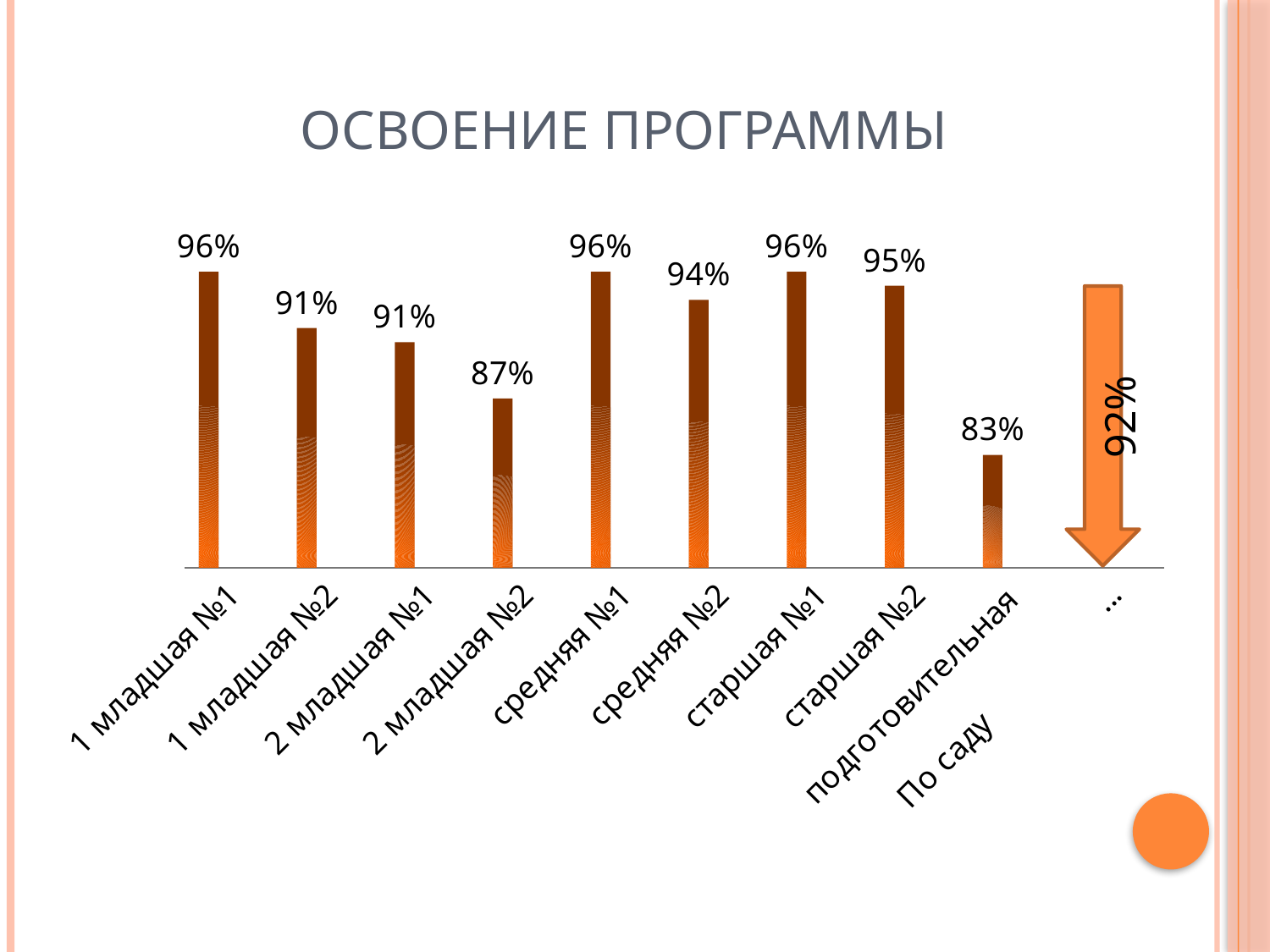
What is the value for средняя №2? 94% What is the value for старшая №2? 95% What is the value for 1 младшая №1? 96% Which is larger, the value for 1 младшая №2 or the value for 2 младшая №2? 1 младшая №2 What is the title of the slide? ОСВОЕНИЕ ПРОГРАММЫ Which group has the lowest value? подготовительная What kind of chart is shown on the slide? bar chart What is the value for 2 младшая №2? 87% How many bars are plotted in the chart? 9 What is the value for подготовительная? 83% What is the difference between the values for старшая №1 and подготовительная? 13% What value is shown on the arrow for По саду? 92%